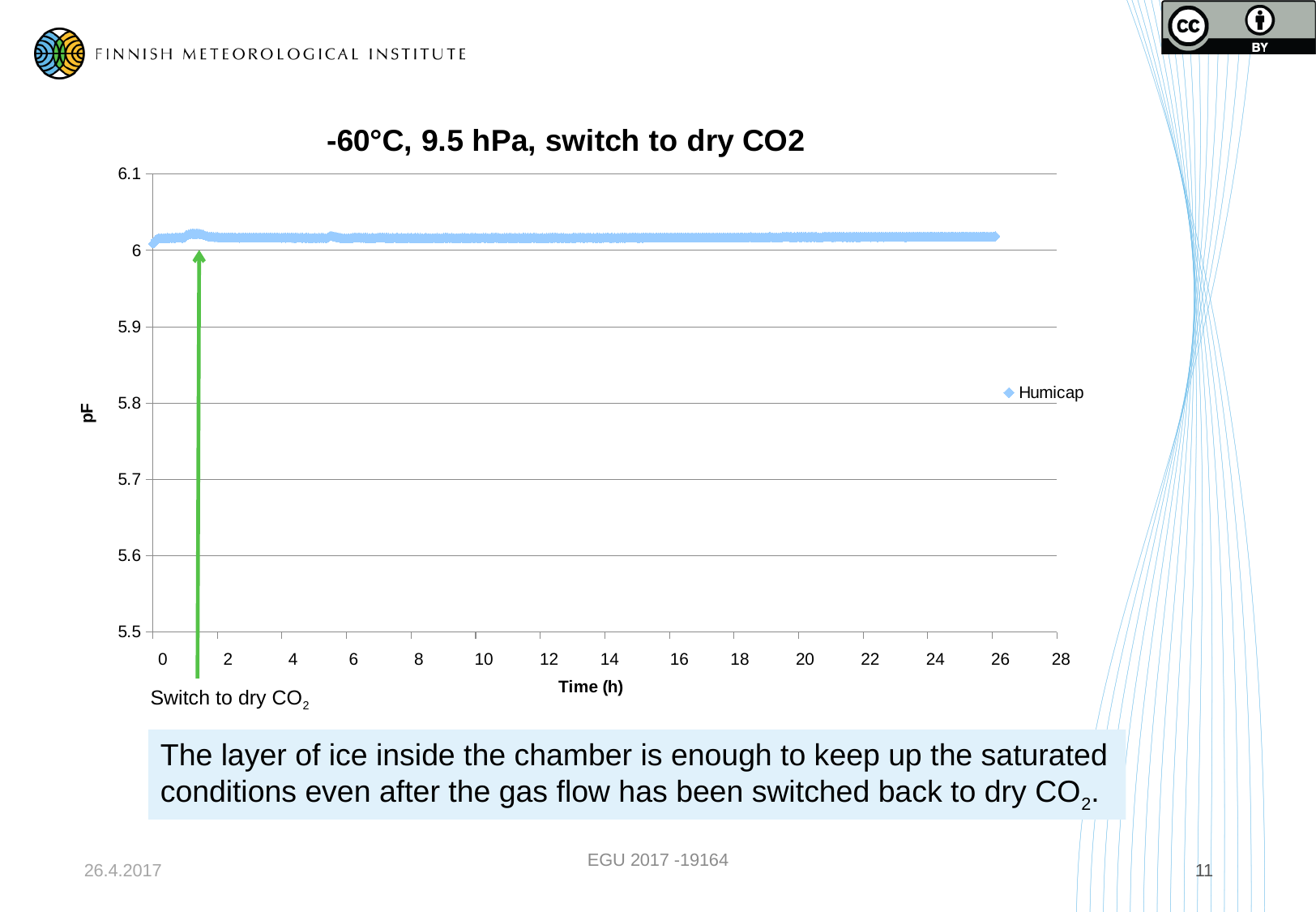
Is the Humicap value at 10 h greater or less than 5.9? greater Do the Humicap values rise, fall, or stay roughly flat as time increases from 0 to 26 h? stay roughly flat Is the Humicap value at 20 h greater or less than 6.1? less How many series does the chart legend list? 1 What is the label of the y axis? pF Is the Humicap value at 4 h greater or less than 5.7? greater What is the name of the series shown in the chart legend? Humicap What kind of chart is shown on the slide? scatter chart What is the label of the x axis? Time (h)